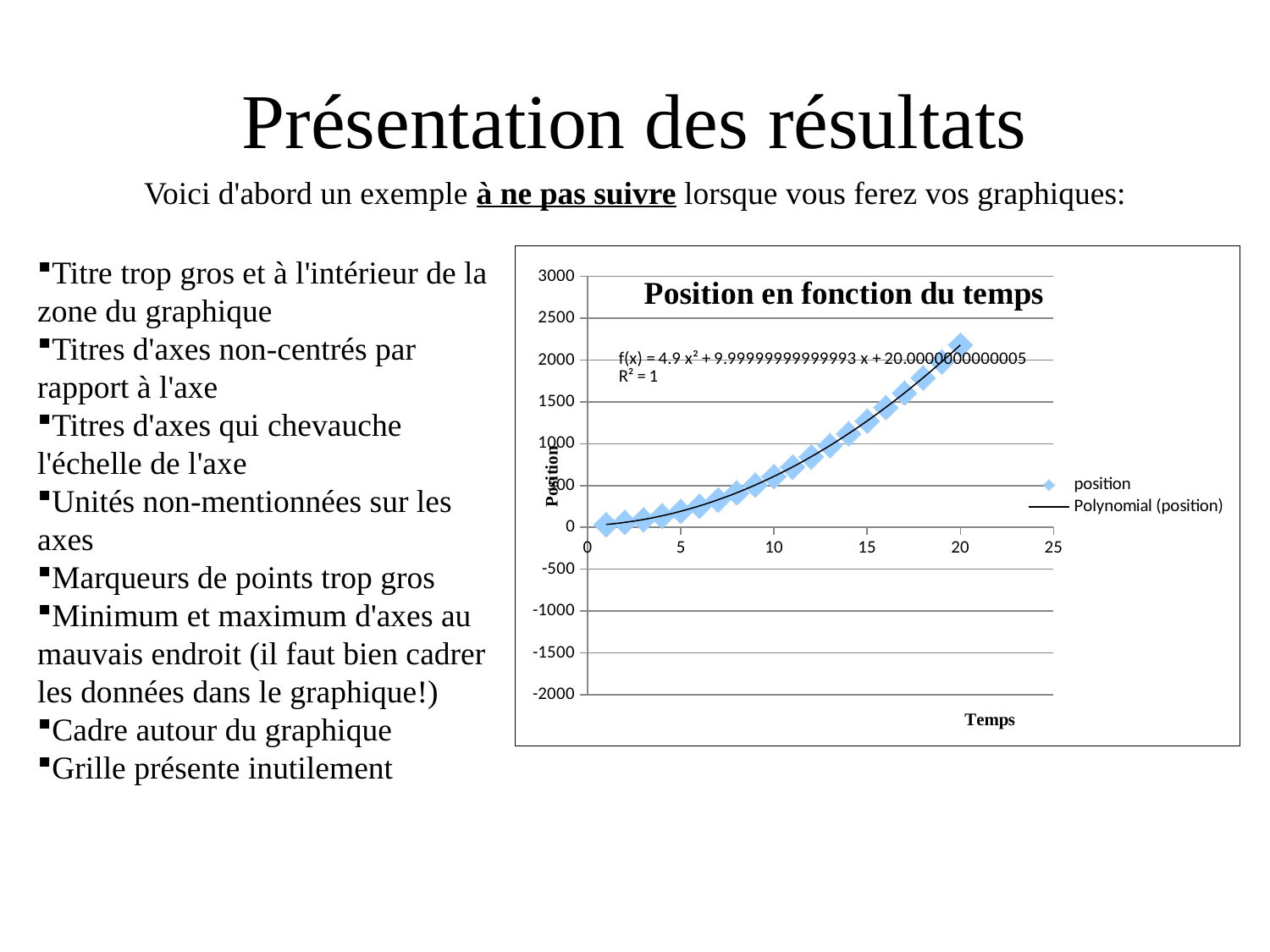
Is the position value at Temps = 20 greater or less than 2000? greater How many entries does the chart legend list? 2 What kind of chart is shown on the slide? scatter chart Is the position value at Temps = 10 greater or less than 500? greater Is the position value at Temps = 5 greater or less than 500? less What is the coefficient of x² in the trendline equation shown on the chart? 4.9 What R² value is displayed for the trendline? R² = 1 Which is larger, the position value at Temps = 20 or at Temps = 5? Temps = 20 Do the position values rise or fall as Temps increases? rise What is the title of the chart? Position en fonction du temps What are the two entries in the chart legend? position, Polynomial (position)